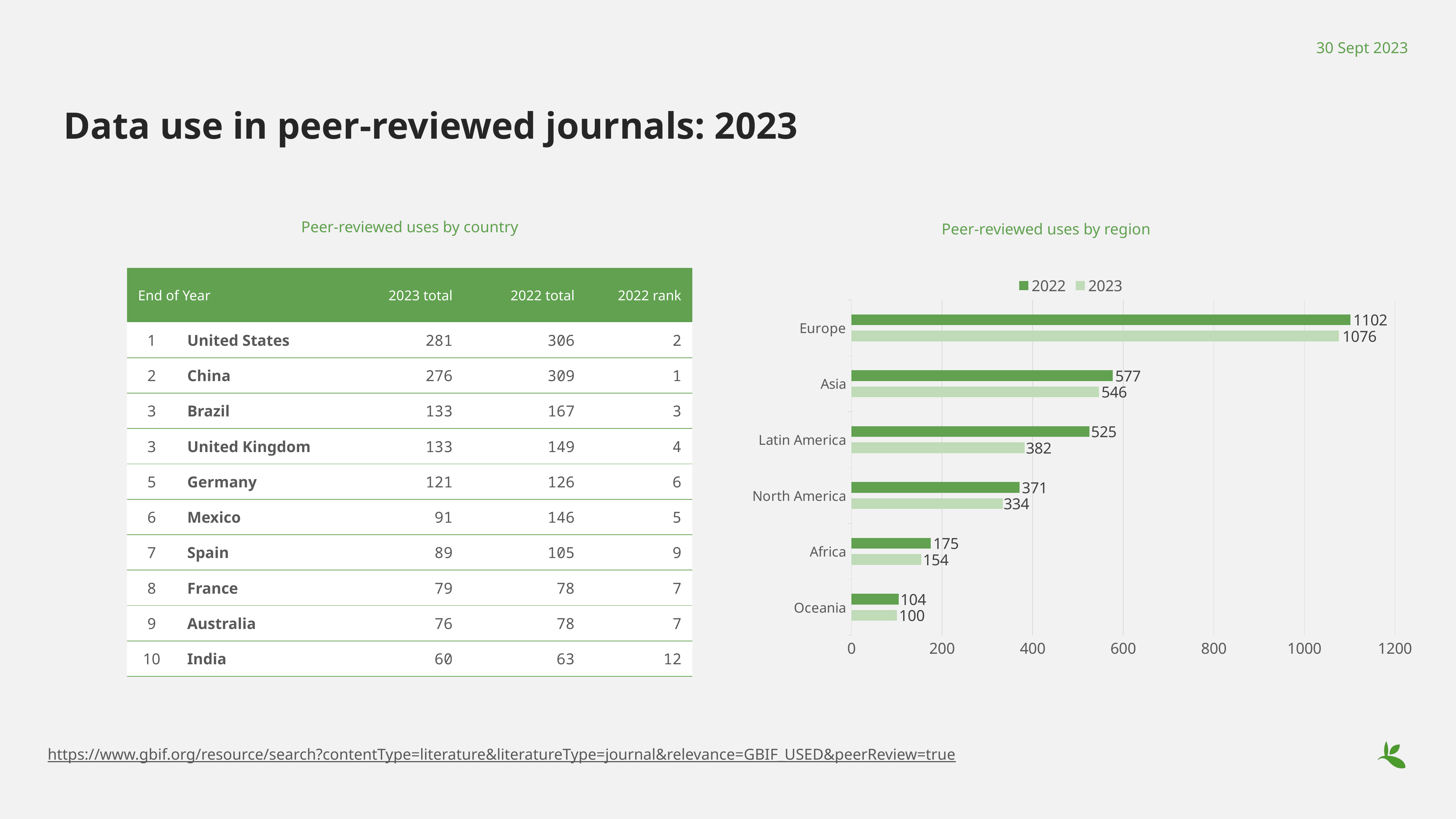
In the 'Peer-reviewed uses by region' chart, what is the difference between the 2022 values for Asia and North America? 206 In the 'Peer-reviewed uses by region' chart, what is the 2022 value for Latin America? 525 How many regions are shown in the 'Peer-reviewed uses by region' chart? 6 In the 'Peer-reviewed uses by region' chart, which region has the lowest 2022 value? Oceania In the 'Peer-reviewed uses by region' chart, what is the difference between the 2022 and 2023 values for Latin America? 143 In the 'Peer-reviewed uses by region' chart, what is the 2023 value for Europe? 1076 In the 'Peer-reviewed uses by region' chart, which region has the highest 2023 value? Europe In the 'Peer-reviewed uses by region' chart, which is larger: the 2023 value for Asia or the 2022 value for Latin America? 2023 value for Asia In the 'Peer-reviewed uses by region' chart, what is the 2023 value for Africa? 154 How many series does the legend of the 'Peer-reviewed uses by region' chart list? 2 What kind of chart is 'Peer-reviewed uses by region'? Bar chart In the 'Peer-reviewed uses by region' chart, is the 2022 value for Europe greater or less than 1000? greater